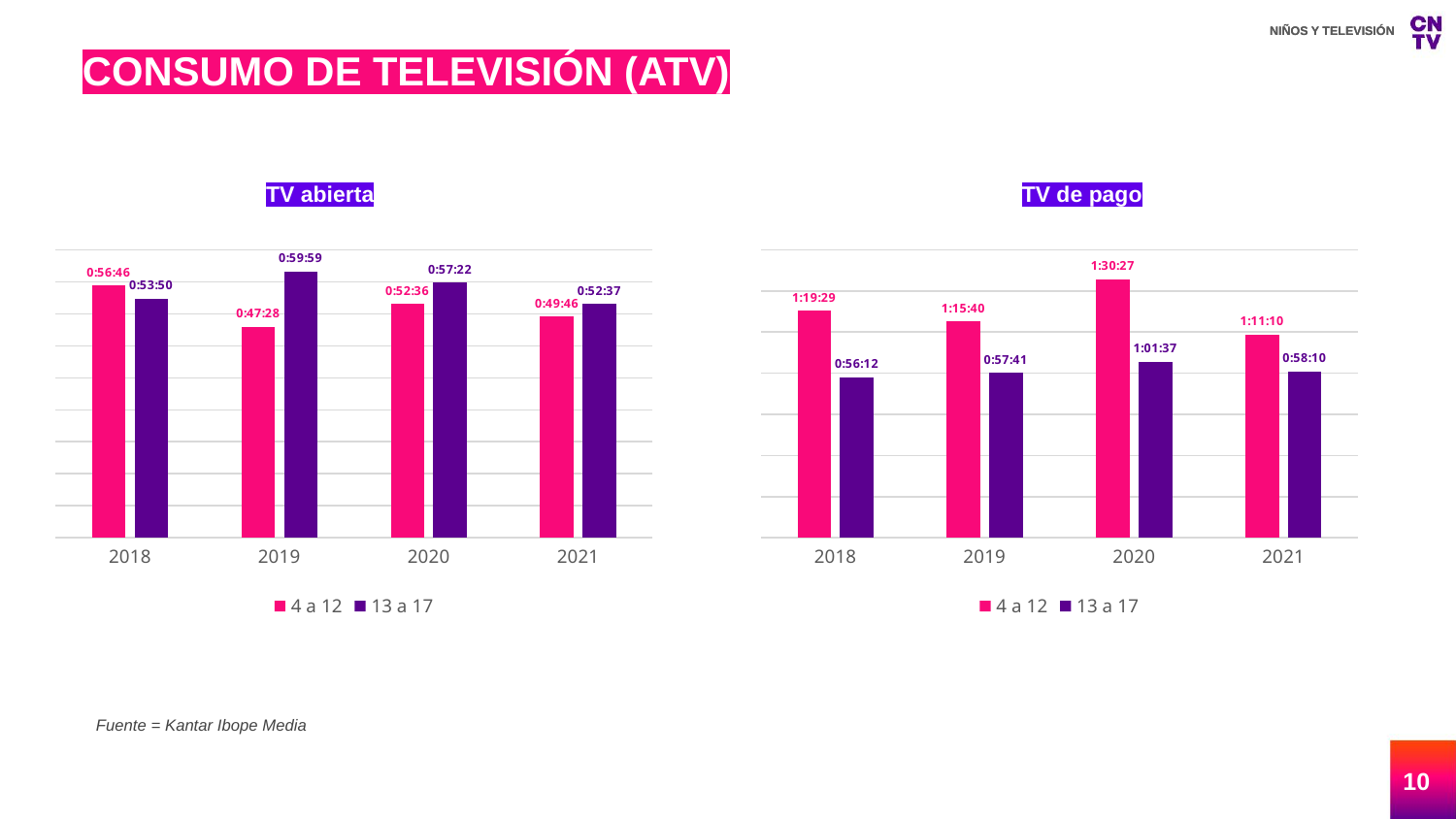
In the TV abierta chart, which is larger in 2018: 4 a 12 or 13 a 17? 4 a 12 In the TV de pago chart, which is larger in 2021: 4 a 12 or 13 a 17? 4 a 12 In the TV de pago chart, what is the value for 4 a 12 in 2020? 1:30:27 How many series does the legend of the TV abierta chart list? 2 In the TV abierta chart, what is the value for 13 a 17 in 2020? 0:57:22 In the TV abierta chart, which year has the highest value for 13 a 17? 2019 In the TV abierta chart, what is the value for 4 a 12 in 2019? 0:47:28 In the TV abierta chart, which year has the lowest value for 4 a 12? 2019 In the TV de pago chart, which year has the lowest value for 4 a 12? 2021 How many years are shown on the x axis of the TV de pago chart? 4 In the TV de pago chart, what is the value for 13 a 17 in 2018? 0:56:12 In the TV de pago chart, what is the difference between 4 a 12 and 13 a 17 in 2020? 0:28:50